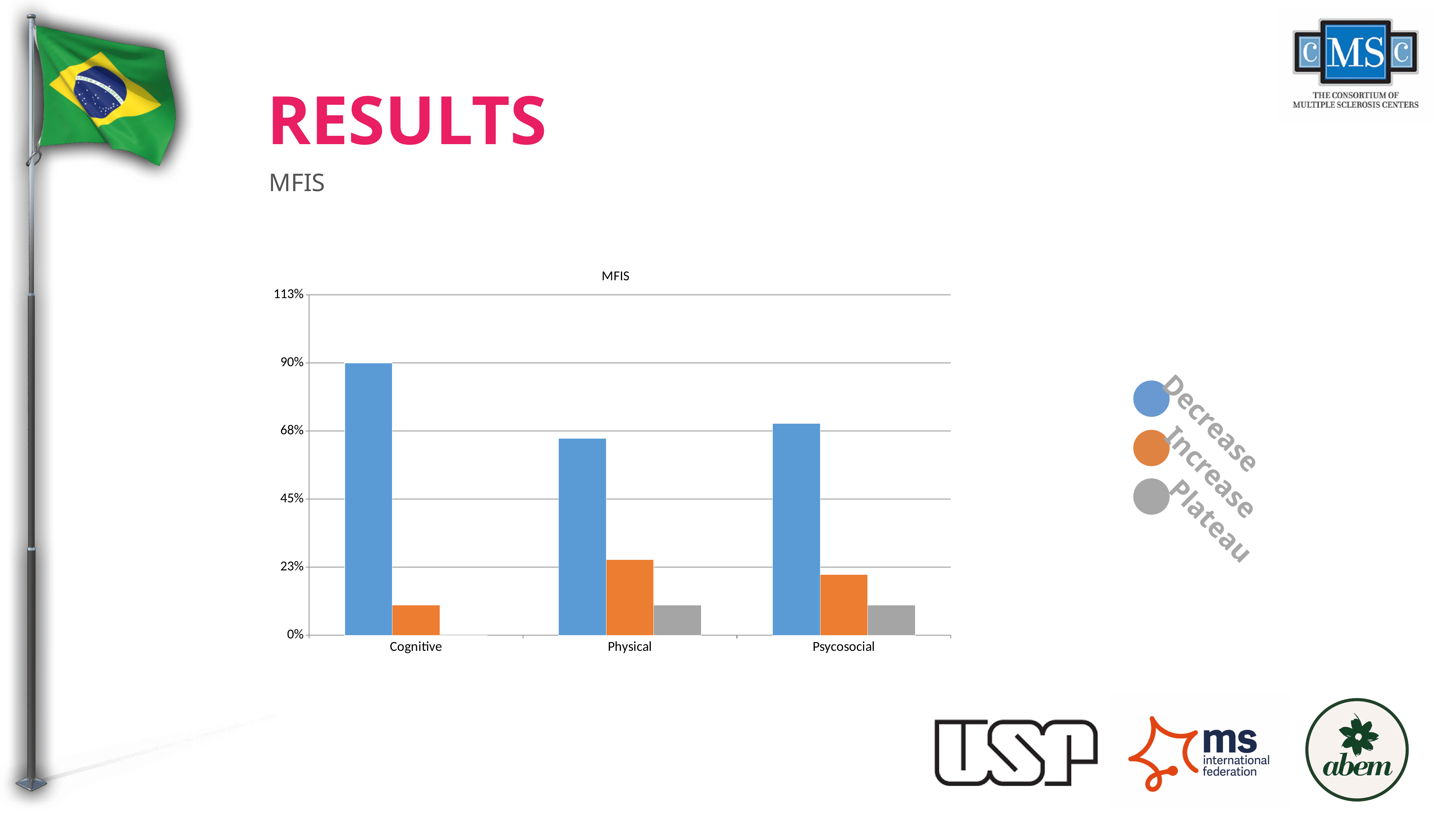
Which colour represents the Decrease series in the legend? blue How many series does the legend list? 3 Is the Plateau value for Psycosocial greater or less than 23%? less Is the Increase value for Cognitive greater or less than 23%? less How many categories are shown on the x axis? 3 What kind of chart is shown on the slide? bar chart What is the title of the chart? MFIS What is the Decrease value for Cognitive? 90% Which category has the highest Increase value? Physical Which category has the highest Decrease value? Cognitive Is the Decrease value for Physical greater or less than 45%? greater Which is larger, the Decrease value for Cognitive or the Decrease value for Physical? Cognitive